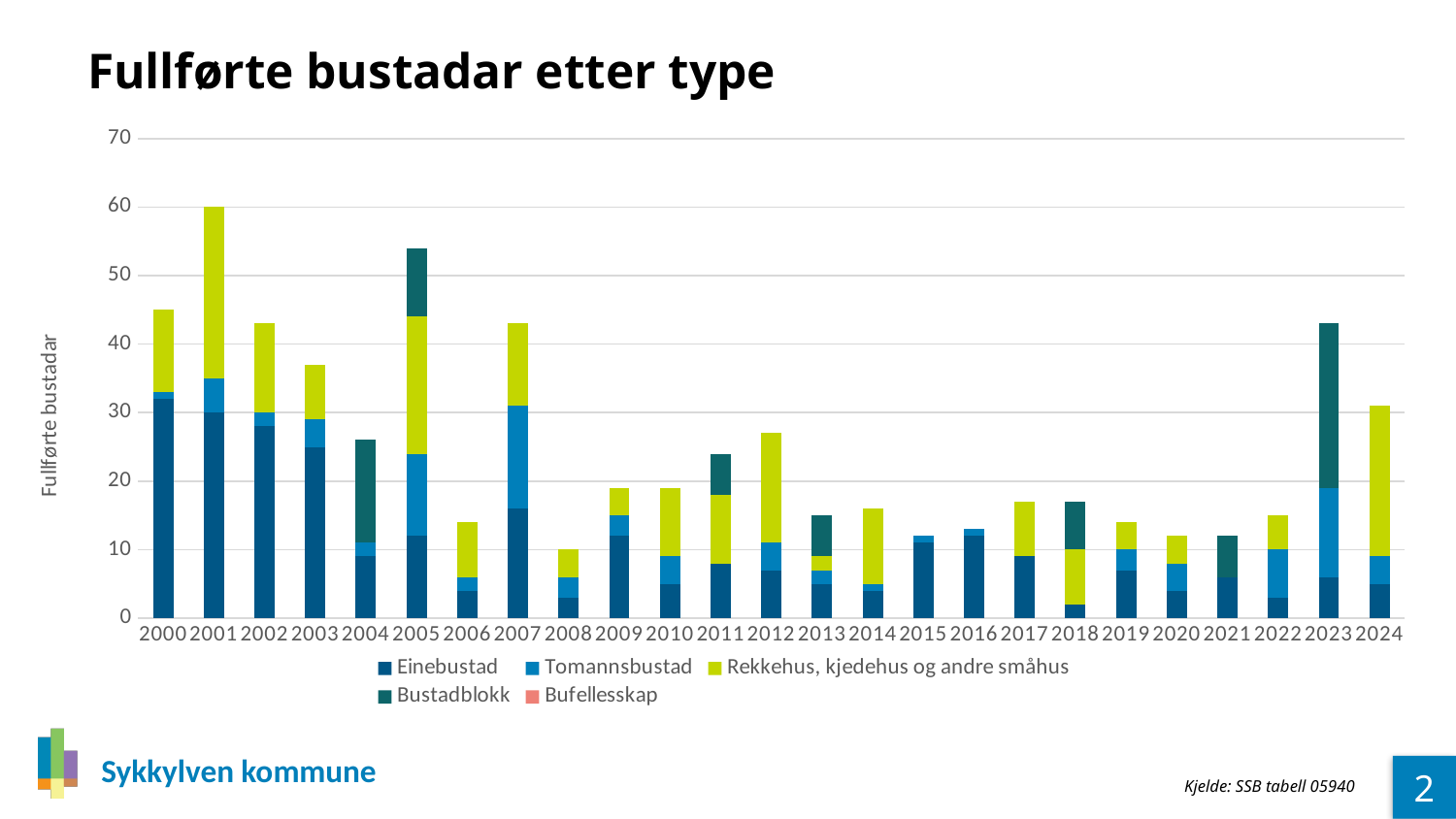
Is the total for 2005 greater or less than 50? greater Is the total for 2013 greater or less than 20? less What is the title of the chart? Fullførte bustadar etter type Which series is shown in yellow-green in the legend? Rekkehus, kjedehus og andre småhus How many series does the legend list? 5 Which year has the larger total, 2000 or 2001? 2001 Is the total for 2024 greater or less than 20? greater How many years are shown along the x axis? 25 Which year has the highest total of completed dwellings? 2001 Which year has the lowest total of completed dwellings? 2008 What kind of chart is shown on the slide? Stacked bar chart